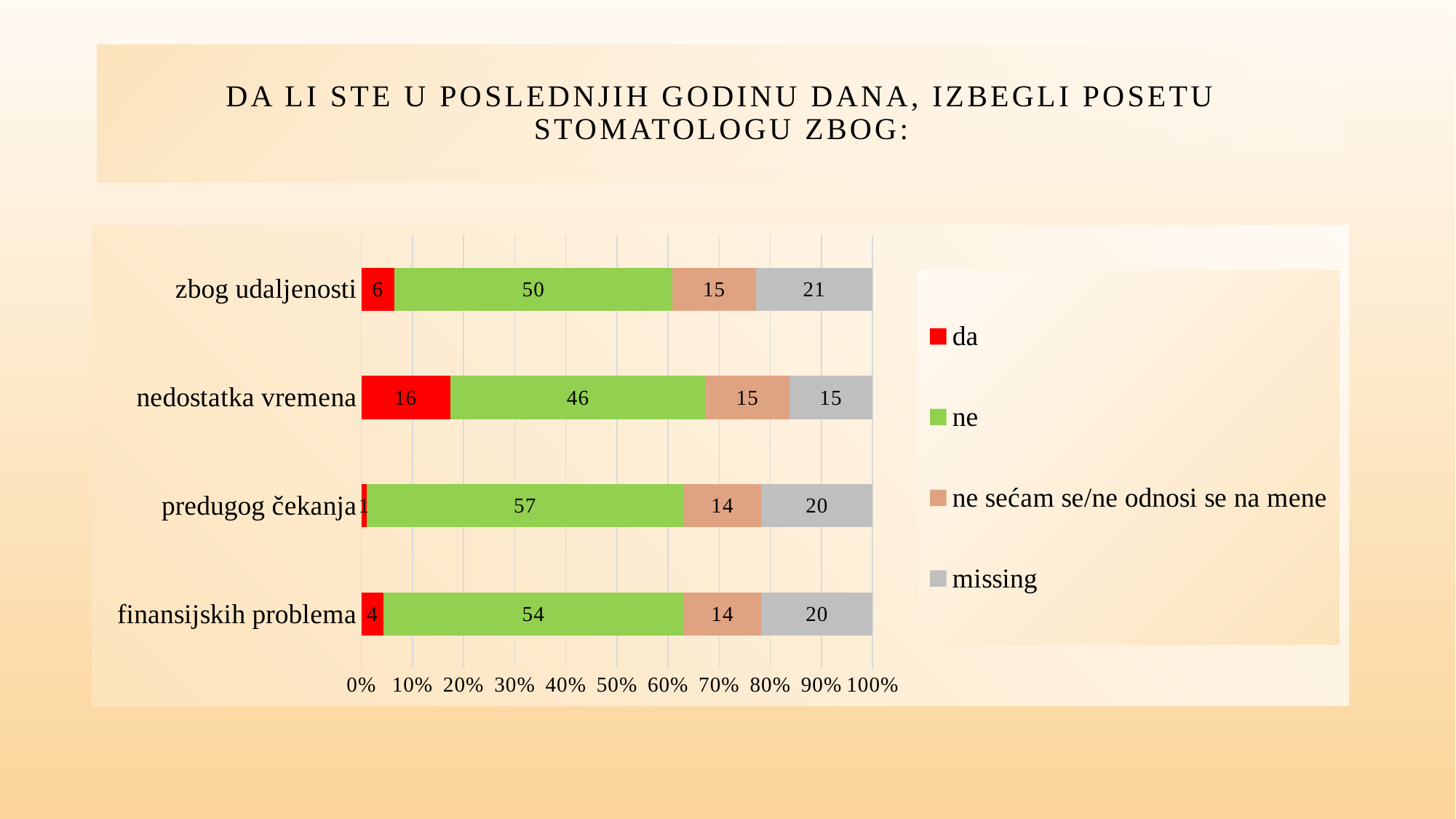
What kind of chart is shown on the slide? Stacked bar chart Which category has the highest value for the "da" series? nedostatka vremena What is the difference between the "ne" values for "predugog čekanja" and "zbog udaljenosti"? 7 What is the value of the "ne" series for "predugog čekanja"? 57 What is the value of the "da" series for "nedostatka vremena"? 16 How many series does the legend list? 4 How many categories are shown on the chart? 4 Which category has the lowest value for the "ne" series? nedostatka vremena What is the value of the "ne sećam se/ne odnosi se na mene" series for "finansijskih problema"? 14 Which is larger: the "da" value for "zbog udaljenosti" or the "da" value for "finansijskih problema"? zbog udaljenosti What is the total of the labelled values in the "nedostatka vremena" bar? 92 What is the value of the "missing" series for "zbog udaljenosti"? 21